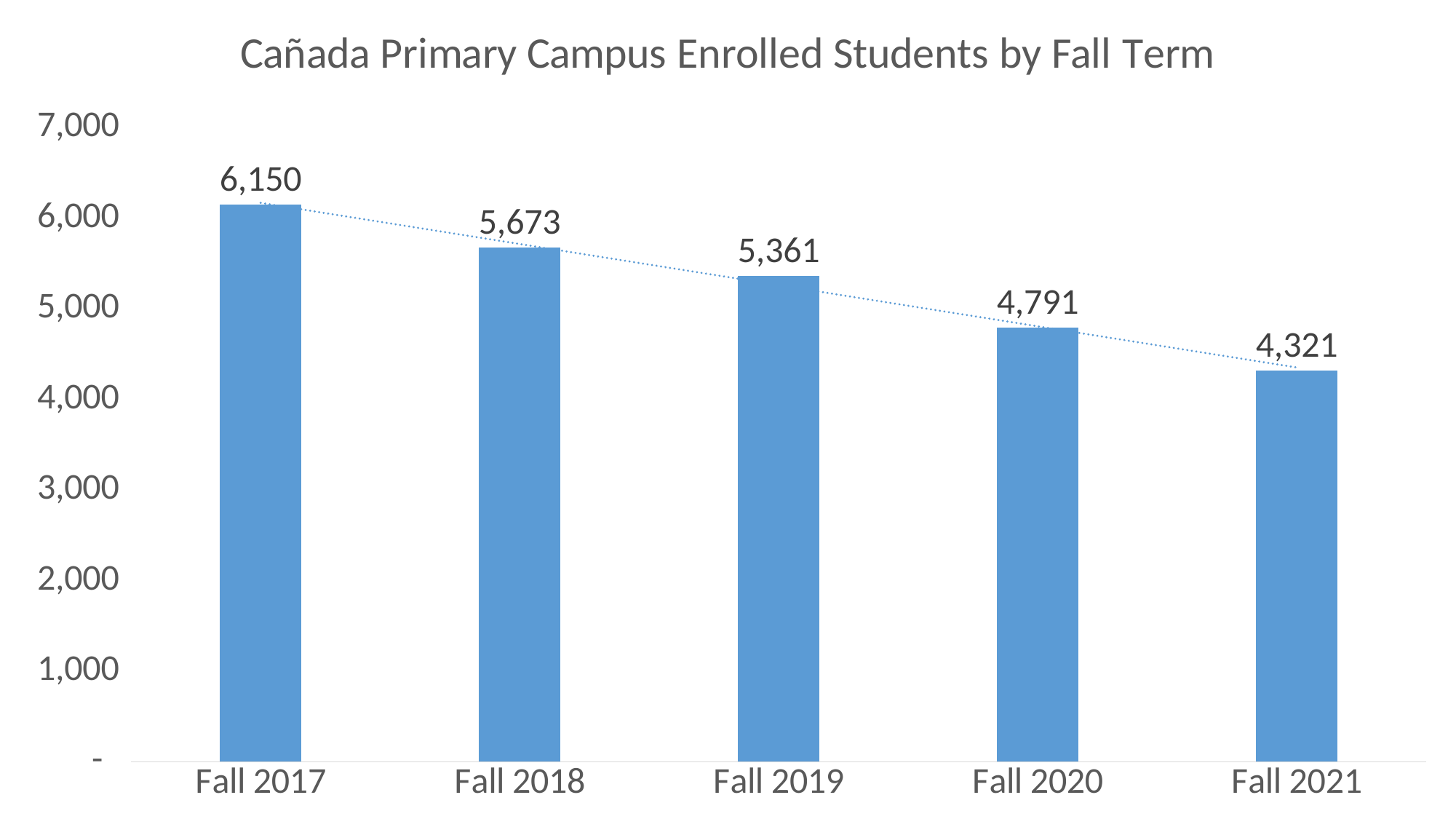
Which fall term has the highest number of enrolled students? Fall 2017 Do the enrolled student numbers rise or fall from Fall 2017 to Fall 2021? Fall What is the number of enrolled students for Fall 2017? 6,150 What is the number of enrolled students for Fall 2019? 5,361 Is the value for Fall 2020 greater or less than 5,000? less How many fall terms are shown on the chart? 5 Which has more enrolled students, Fall 2018 or Fall 2020? Fall 2018 What is the number of enrolled students for Fall 2021? 4,321 What is the difference in enrolled students between Fall 2018 and Fall 2019? 312 What is the difference in enrolled students between Fall 2017 and Fall 2021? 1,829 Which fall term has the lowest number of enrolled students? Fall 2021 What kind of chart is shown on the slide? Bar chart